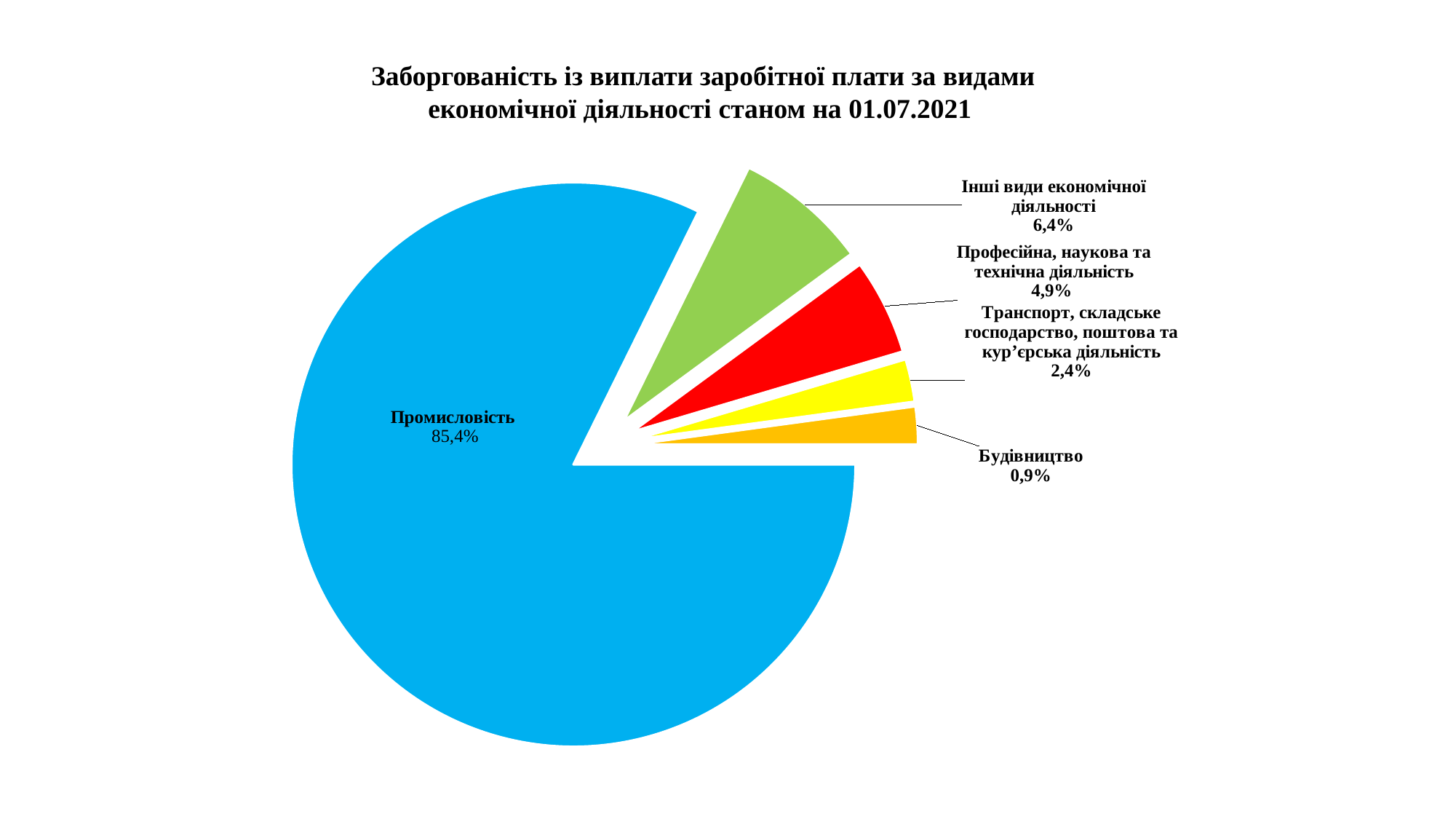
How many slices does the pie chart have? 5 What kind of chart is shown on the slide? Pie chart What is the difference between Інші види економічної діяльності and Професійна, наукова та технічна діяльність? 1,5% What is the value for Будівництво? 0,9% Which category has the largest share? Промисловість What colour is the Промисловість slice? Blue What share of the pie does Промисловість have? 85,4% Which category has the smallest share? Будівництво What is the value for Інші види економічної діяльності? 6,4% What is the value for Професійна, наукова та технічна діяльність? 4,9% Which is larger: Транспорт, складське господарство, поштова та кур’єрська діяльність or Будівництво? Транспорт, складське господарство, поштова та кур’єрська діяльність What is the value for Транспорт, складське господарство, поштова та кур’єрська діяльність? 2,4%